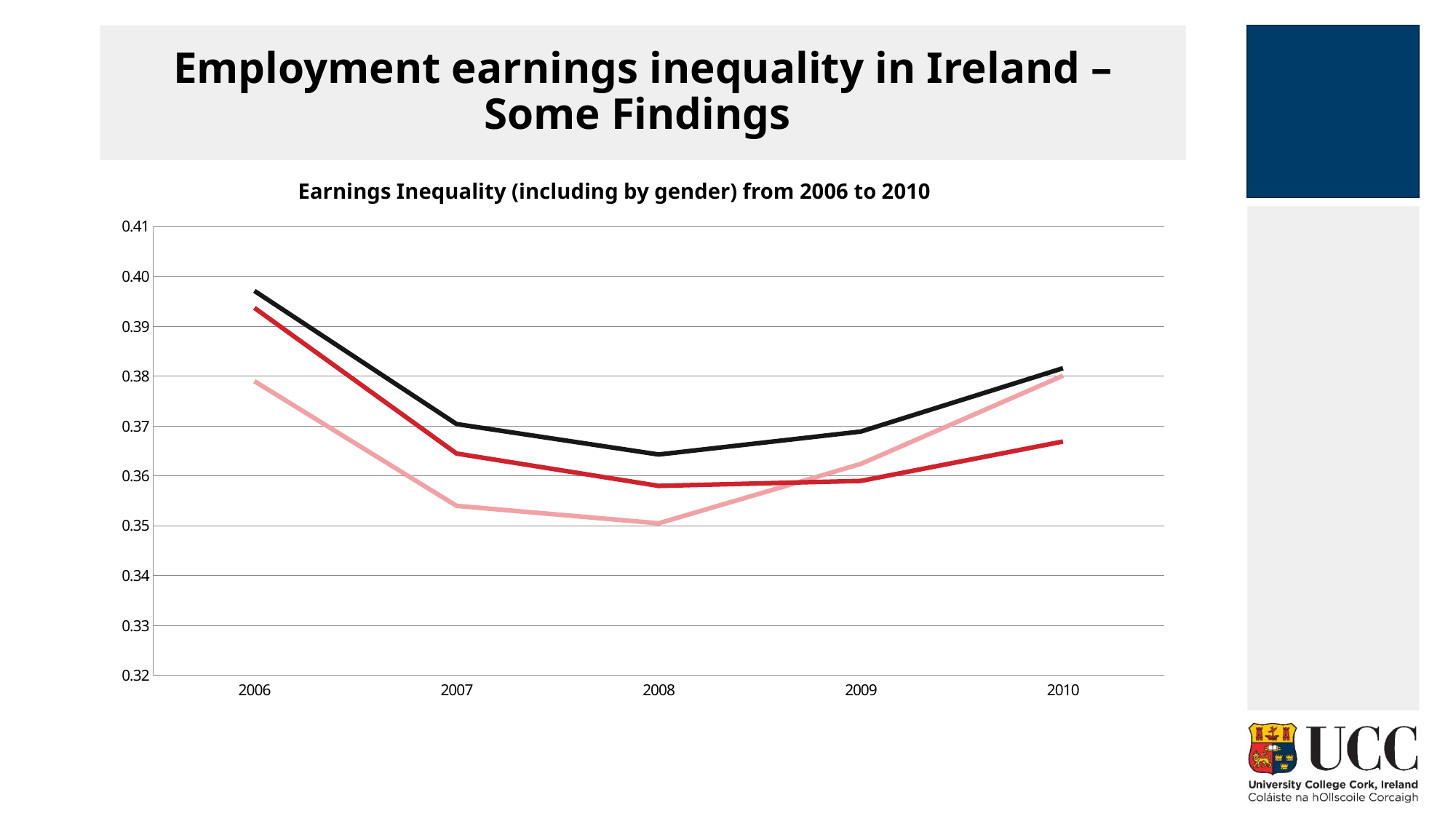
In 2010, which line has the higher value, the pink line or the red line? the pink line How many years are shown on the x axis of the chart? 5 In which year does the pink line reach its lowest value? 2008 What kind of chart is shown on the slide? line chart What is the title of the chart? Earnings Inequality (including by gender) from 2006 to 2010 Does the black line rise or fall from 2006 to 2008? fall Is the value of the black line in 2006 greater or less than 0.39? greater How many lines are plotted on the chart? 3 In which year does the black line reach its lowest value? 2008 Is the value of the red line in 2008 greater or less than 0.36? less In which year does the black line reach its highest value? 2006 Does the pink line rise or fall from 2008 to 2010? rise